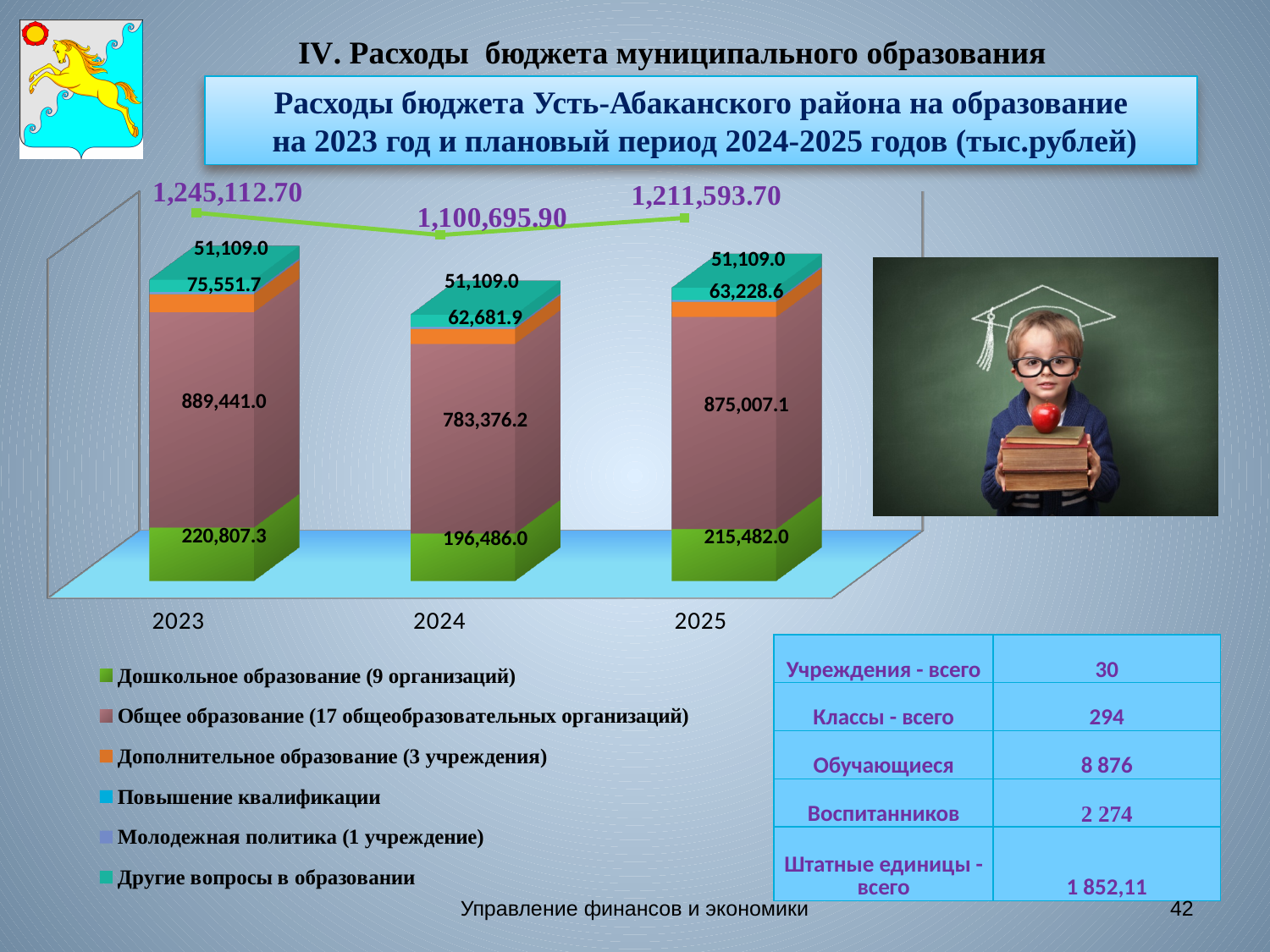
What kind of chart is used to show the education expenditures? Stacked bar chart Which is larger: the Дошкольное образование value for 2023 or for 2025? 2023 Which year has the highest total shown on the line? 2023 What total is shown by the line marker above the 2024 bar? 1,100,695.90 What is the difference between the Общее образование values for 2023 and 2024? 106,064.8 What is the value of the Дошкольное образование segment for 2023? 220,807.3 Which year has the lowest value for the Дошкольное образование segment? 2024 Does the total shown on the line rise or fall from 2023 to 2024? Fall What is the value of the Общее образование segment for 2025? 875,007.1 How many years are shown on the x axis of the chart? 3 How many series does the legend list? 6 What is the value of the Общее образование segment for 2024? 783,376.2